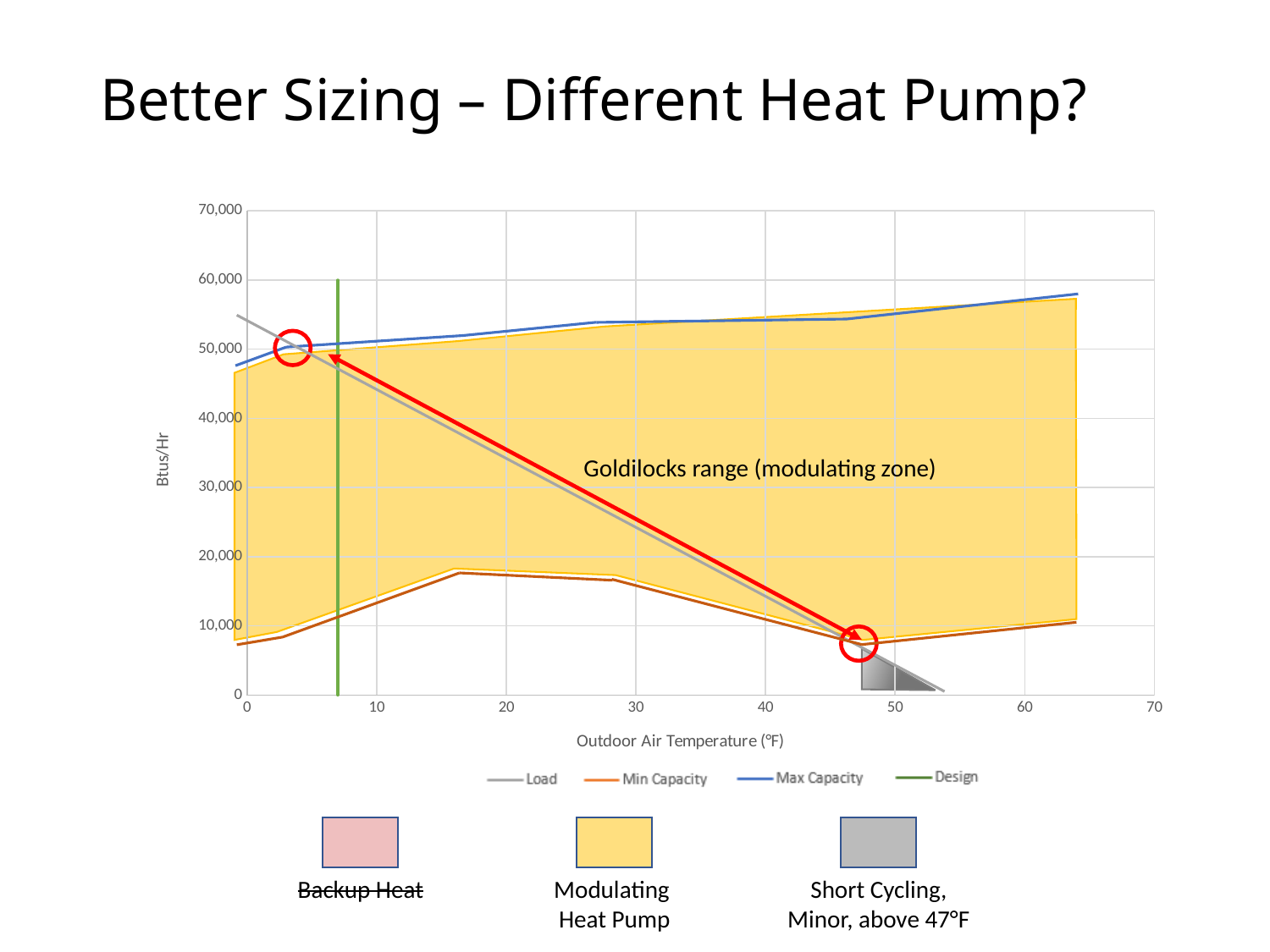
What is the title of the chart's vertical axis? Btus/Hr What are the series names listed in the chart legend? Load, Min Capacity, Max Capacity, Design Is the Load value at 0°F greater or less than 50,000? greater Does the Max Capacity series generally rise or fall as outdoor air temperature increases? rise Is the Max Capacity value at 0°F greater or less than 40,000? greater Is the Load value at 40°F greater or less than 20,000? less How many series does the chart legend list? 4 What kind of chart is shown on the slide? line chart Does the Load series rise or fall as outdoor air temperature increases? fall At 20°F, which is larger: the Load value or the Min Capacity value? Load